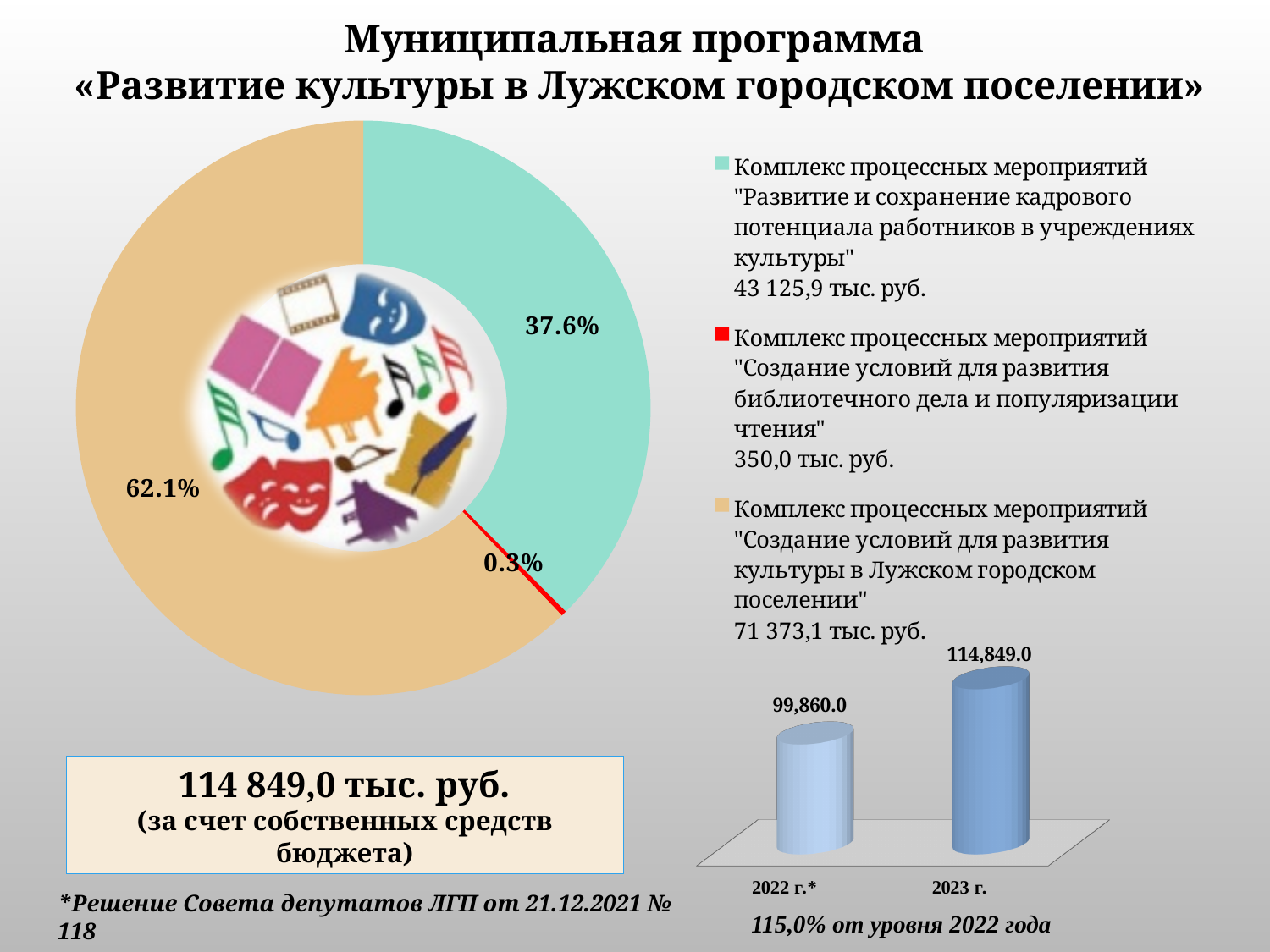
In the bar chart at the bottom right, what is the value for 2023 г.? 114,849.0 In the bar chart at the bottom right, do the values rise or fall from 2022 г.* to 2023 г.? rise In the bar chart at the bottom right, what is the difference between the 2023 г. and 2022 г.* values? 14,989.0 What kind of chart is shown at the bottom right of the slide? bar chart In the pie chart on the left, what share is labelled for the slice representing "Создание условий для развития культуры в Лужском городском поселении"? 62.1% In the pie chart on the left, what share is labelled for the slice representing "Развитие и сохранение кадрового потенциала работников в учреждениях культуры"? 37.6% What kind of chart is shown on the left of the slide? doughnut chart In the pie chart on the left, which slice is the smallest? Создание условий для развития библиотечного дела и популяризации чтения (0.3%) How many entries does the legend of the pie chart on the left list? 3 In the pie chart on the left, which slice is the largest? Создание условий для развития культуры в Лужском городском поселении (62.1%) In the bar chart at the bottom right, what is the value for 2022 г.*? 99,860.0 In the pie chart on the left, what share is labelled for the slice representing "Создание условий для развития библиотечного дела и популяризации чтения"? 0.3%